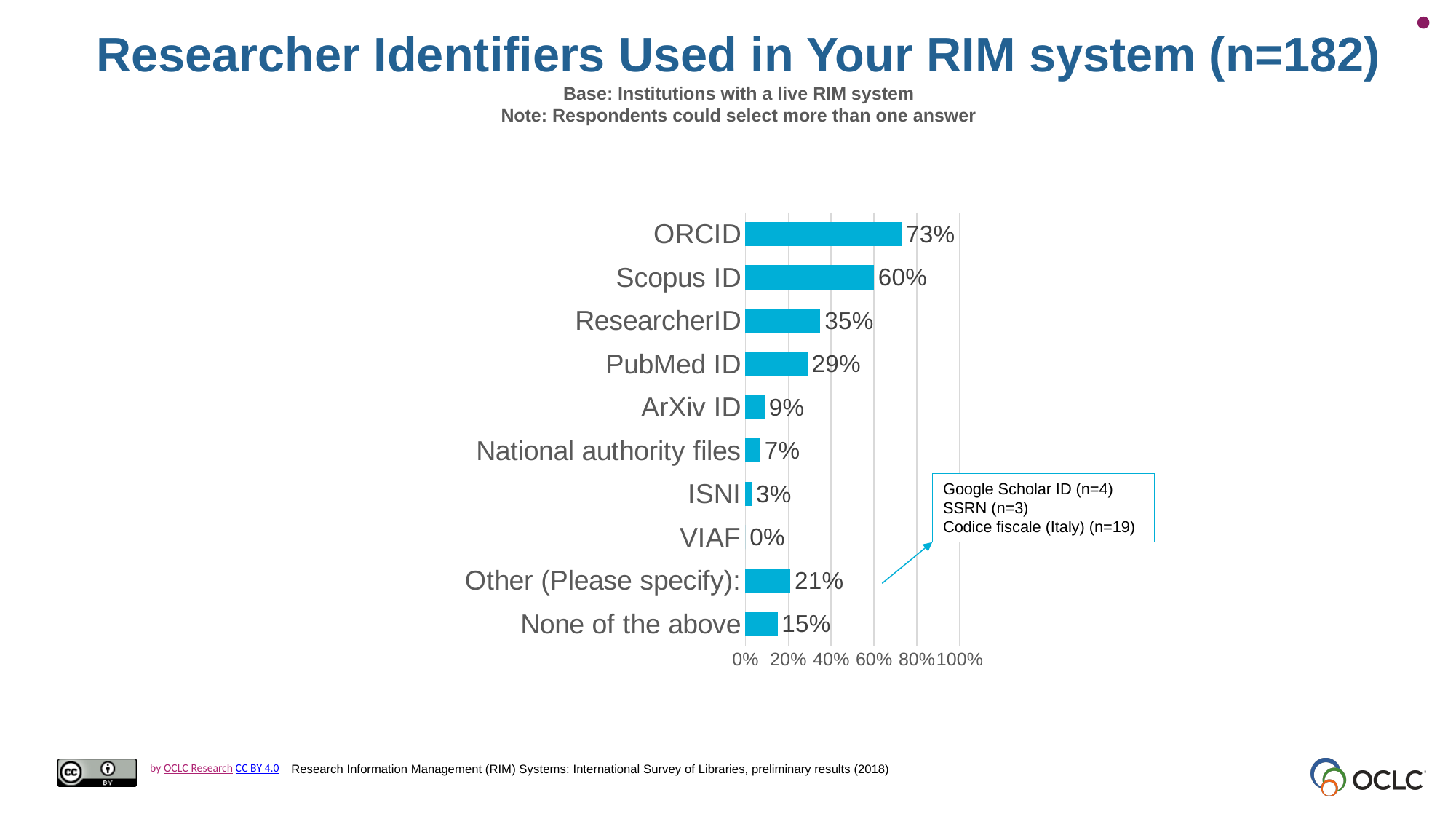
What is the difference between the values for Other (Please specify) and None of the above? 6% How many categories are plotted on the chart? 10 What is the value shown for Scopus ID? 60% What percentage of respondents use ORCID in their RIM system? 73% What kind of chart is shown on the slide? Bar chart Which researcher identifier has the highest percentage? ORCID Which is larger, the value for ResearcherID or the value for PubMed ID? ResearcherID Which category has the lowest value on the chart? VIAF What is the difference in percentage points between ORCID and Scopus ID? 13% What is the title of the chart on the slide? Researcher Identifiers Used in Your RIM system (n=182) What is the value for VIAF? 0% What percentage is shown for PubMed ID? 29%